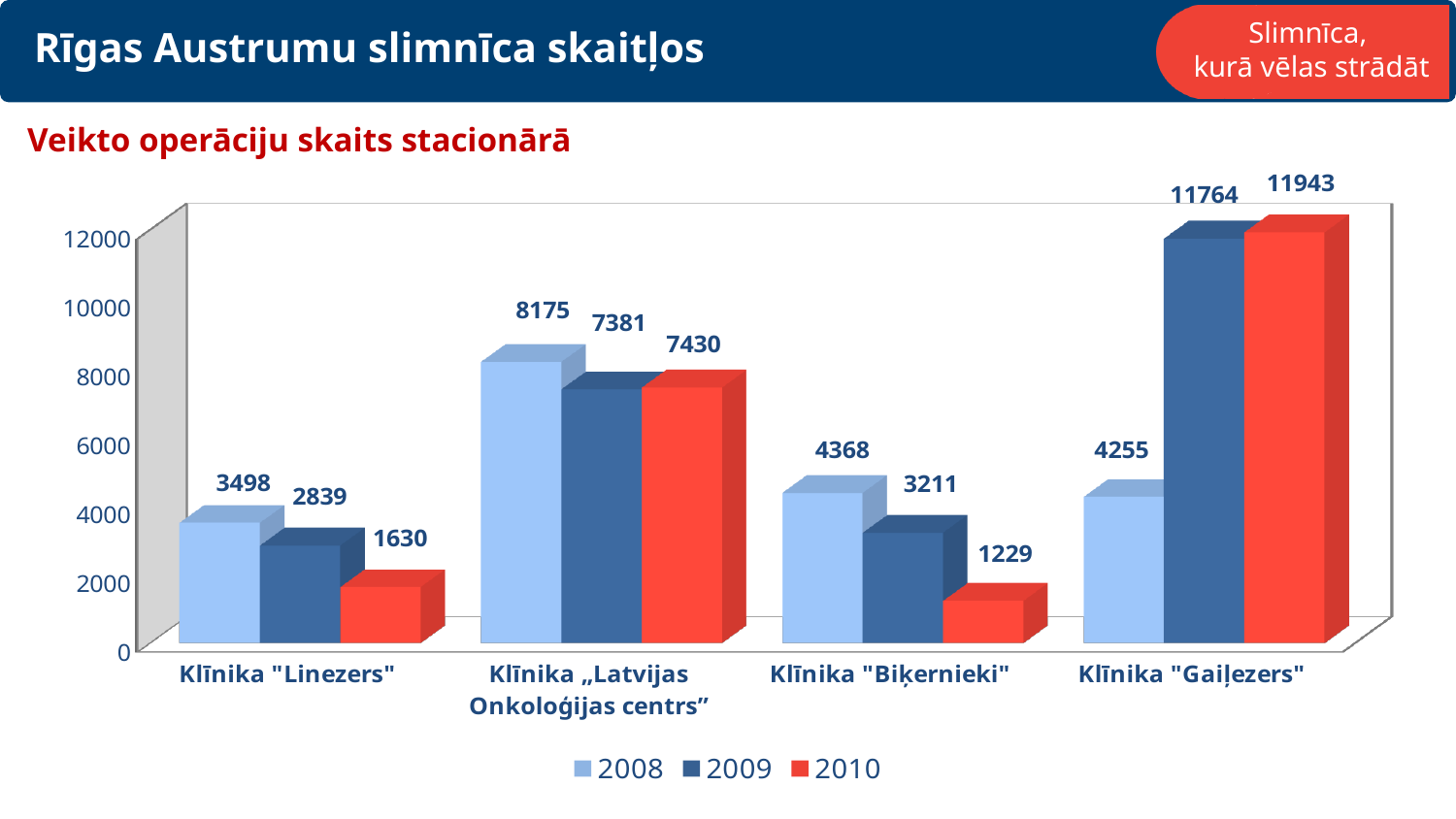
Which clinic has the lowest value in 2010? Klīnika "Biķernieki" What is the difference between the 2009 and 2010 values for Klīnika "Gaiļezers"? 179 How many series does the legend list? 3 Which clinic has the highest value in 2010? Klīnika "Gaiļezers" What is the value for Klīnika "Biķernieki" in 2009? 3211 Which is larger for Klīnika "Linezers": the 2008 value or the 2010 value? 2008 What is the value for Klīnika "Linezers" in 2008? 3498 What is the value for Klīnika "Gaiļezers" in 2010? 11943 Is the 2008 value for Klīnika "Biķernieki" greater or less than 4000? greater What kind of chart is shown on the slide? Bar chart What is the value for Klīnika „Latvijas Onkoloģijas centrs” in 2010? 7430 How many clinics are shown on the x axis? 4